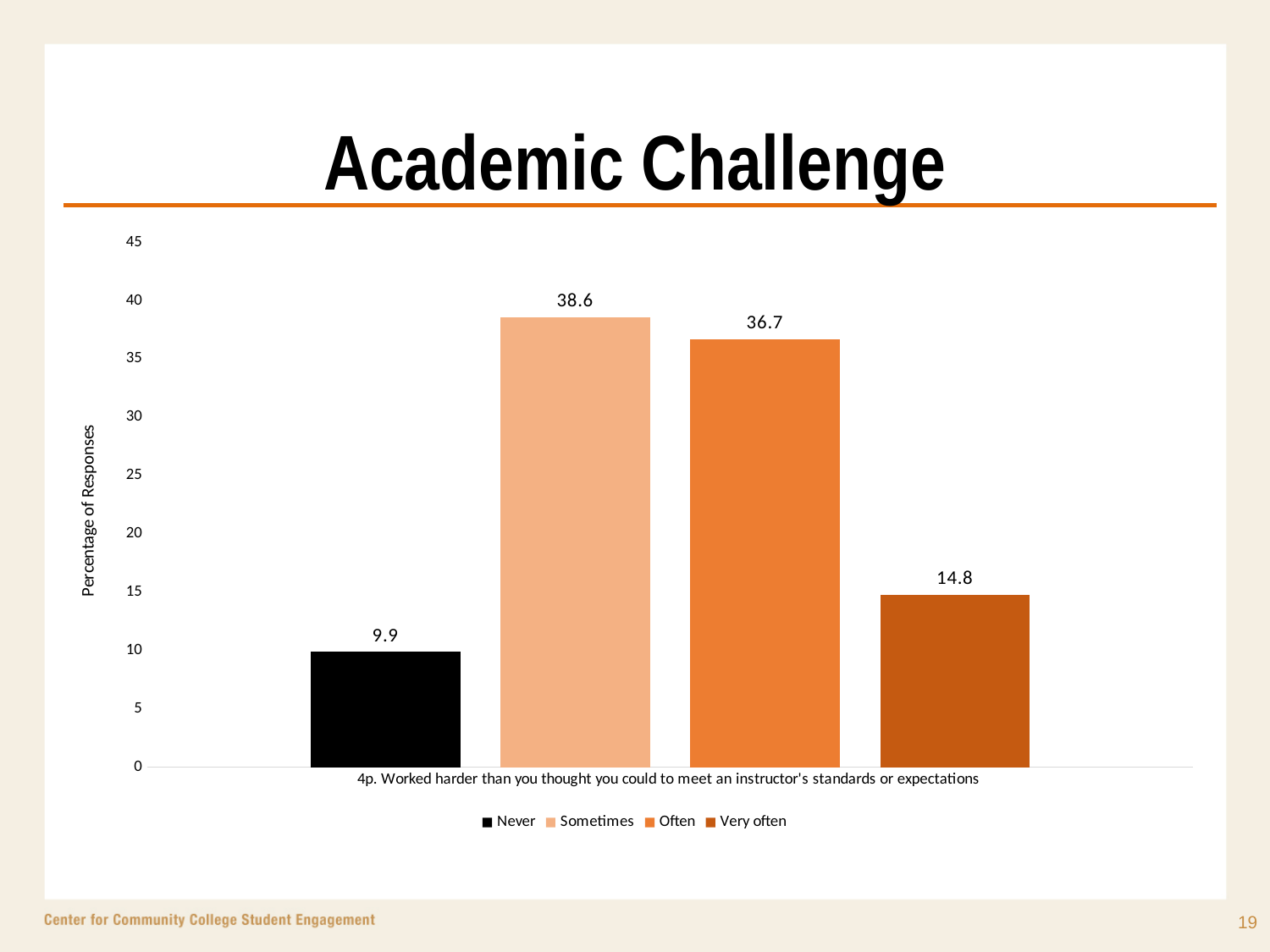
What is the label of the vertical axis? Percentage of Responses Which response option has the highest value? Sometimes What is the value for Never? 9.9 What kind of chart is shown on the slide? Bar chart What is the value for Sometimes? 38.6 What is the value for Very often? 14.8 How many series does the legend list? 4 What is the value for Often? 36.7 Which is larger, the value for Very often or the value for Never? Very often Which response option has the lowest value? Never What is the difference between the values for Sometimes and Often? 1.9 What is the difference between the values for Very often and Never? 4.9